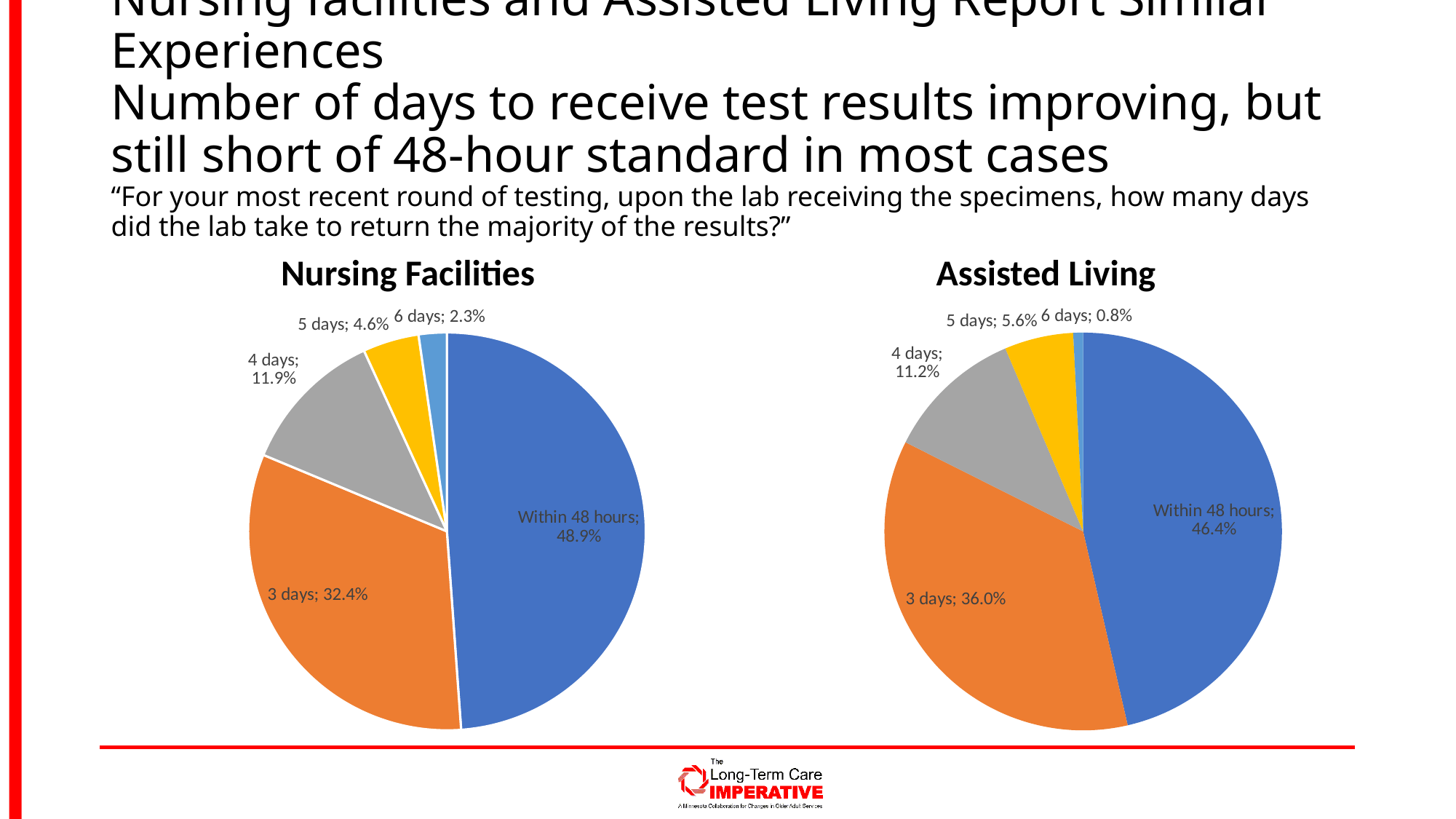
In the Nursing Facilities pie chart, what is the value for 4 days? 11.9% In the Assisted Living pie chart, what is the value for 6 days? 0.8% What type of chart is used for Nursing Facilities? Pie chart In the Assisted Living pie chart, what is the combined share of 4 days, 5 days and 6 days? 17.6% Which chart shows a larger share for 5 days, Nursing Facilities or Assisted Living? Assisted Living What colour is the 3 days slice in both pie charts? Orange How many categories are shown in the Assisted Living pie chart? 5 In the Assisted Living pie chart, what share of respondents received results in 3 days? 36.0% In the Nursing Facilities pie chart, what is the difference between the Within 48 hours share and the 3 days share? 16.5% In the Nursing Facilities pie chart, which category has the largest share? Within 48 hours In the Nursing Facilities pie chart, what share of respondents received results within 48 hours? 48.9% In the Assisted Living pie chart, which category has the smallest share? 6 days